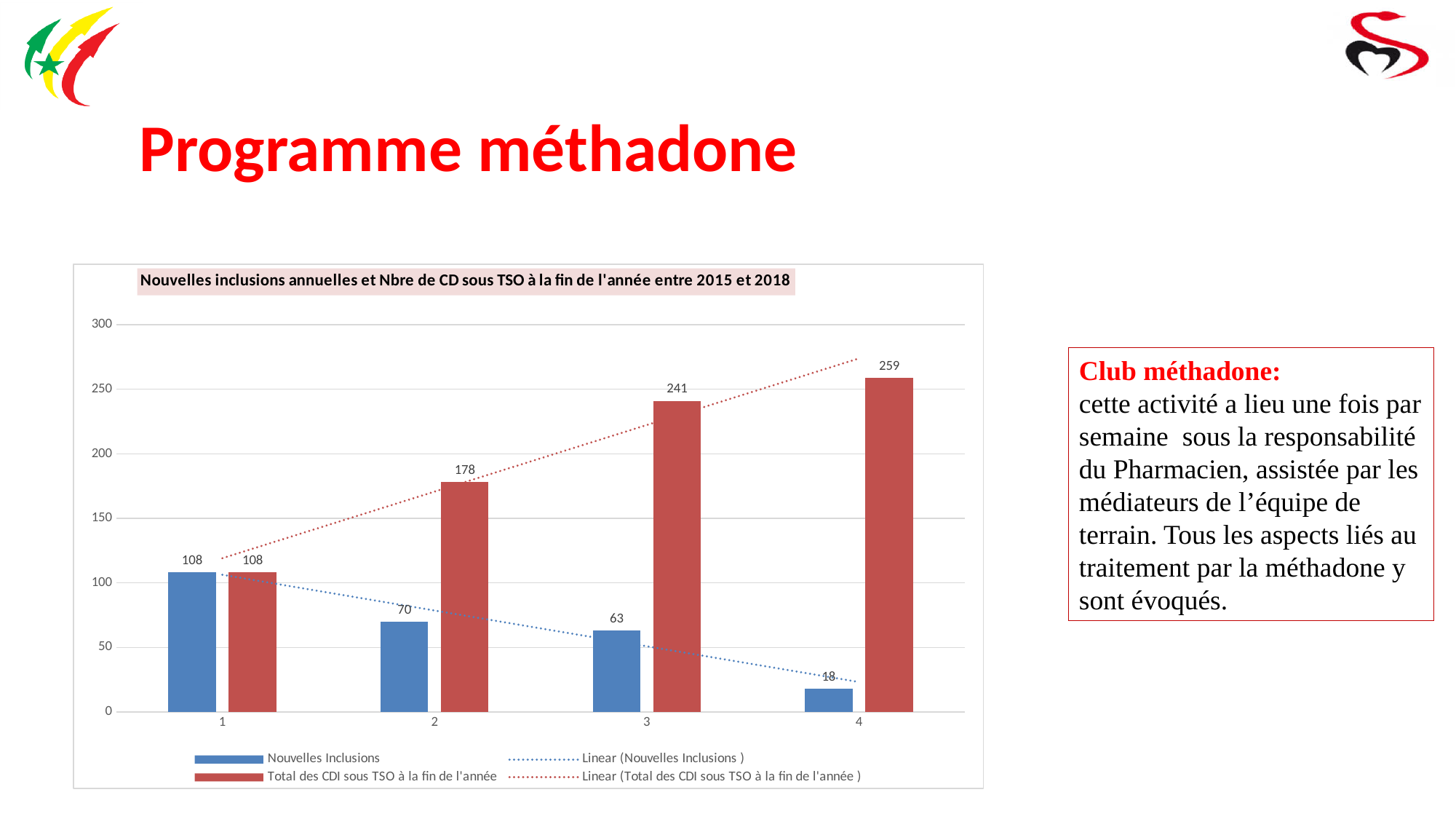
What is the value of Nouvelles Inclusions for category 4? 18 Which category has the highest value for Total des CDI sous TSO à la fin de l'année? 4 How many entries does the legend list? 4 What is the difference between the Total des CDI sous TSO à la fin de l'année values for category 4 and category 3? 18 For category 2, which series has the larger value: Nouvelles Inclusions or Total des CDI sous TSO à la fin de l'année? Total des CDI sous TSO à la fin de l'année What is the value of Nouvelles Inclusions for category 2? 70 Do the Nouvelles Inclusions values rise or fall from category 1 to category 4? Fall How many categories are shown on the x axis? 4 What kind of chart is shown on the slide? Bar chart What is the value of Total des CDI sous TSO à la fin de l'année for category 3? 241 What is the title of the chart? Nouvelles inclusions annuelles et Nbre de CD sous TSO à la fin de l'année entre 2015 et 2018 Which category has the lowest value for Nouvelles Inclusions? 4